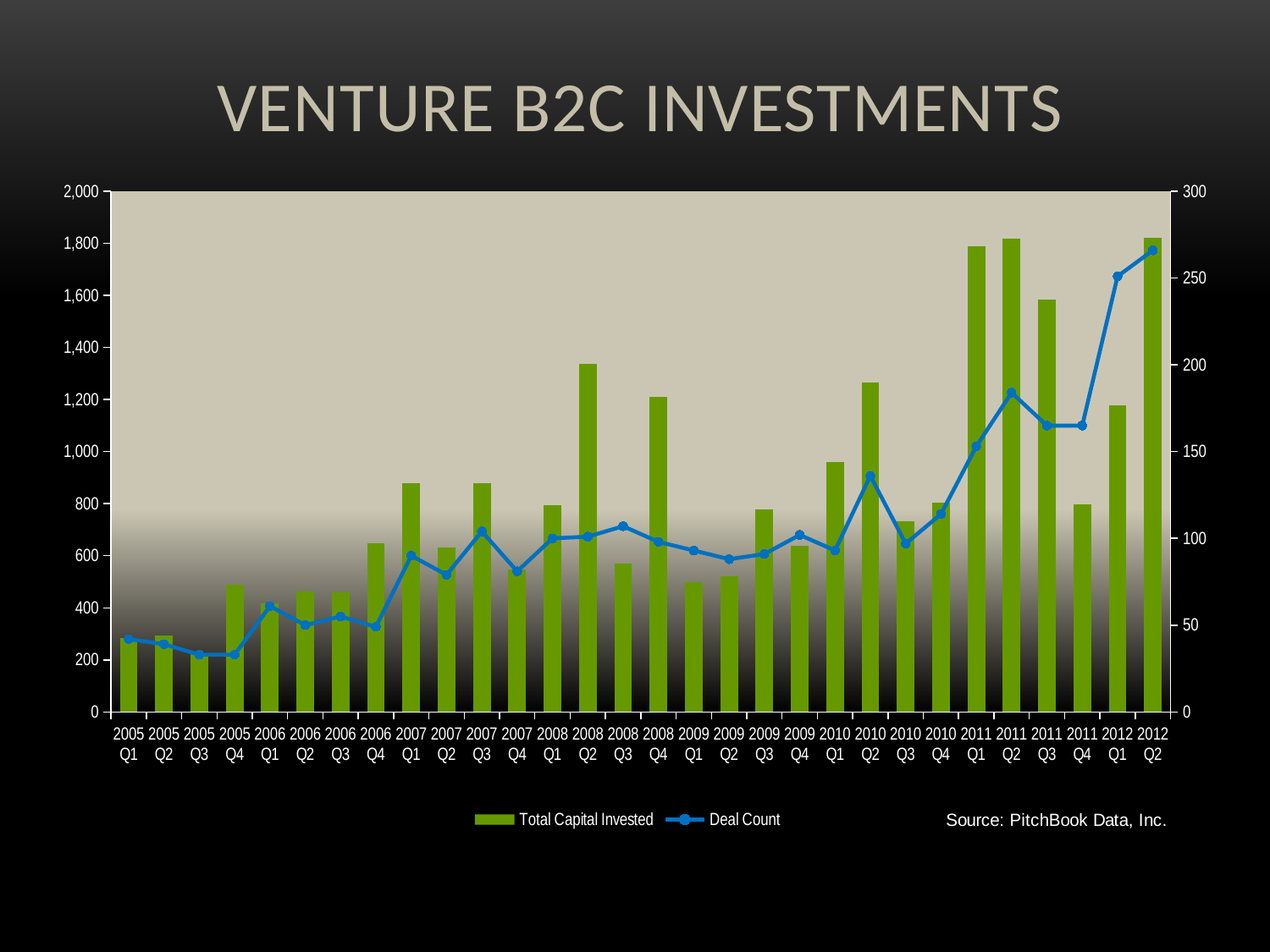
In which quarter is the Deal Count line at its highest? 2012 Q2 Is the Deal Count for 2011 Q2 greater or less than 150? greater What are the two series named in the legend? Total Capital Invested and Deal Count How many quarters are plotted along the x axis? 30 How many series does the legend list? 2 Is the Total Capital Invested bar for 2011 Q1 greater or less than 1,600? greater Which quarter has the larger Total Capital Invested bar, 2008 Q2 or 2008 Q3? 2008 Q2 Is the Total Capital Invested bar for 2008 Q2 greater or less than 1,200? greater Does the Deal Count line rise or fall from 2010 Q4 to 2012 Q2? Rises What kind of chart is shown on the slide? A combined bar and line chart